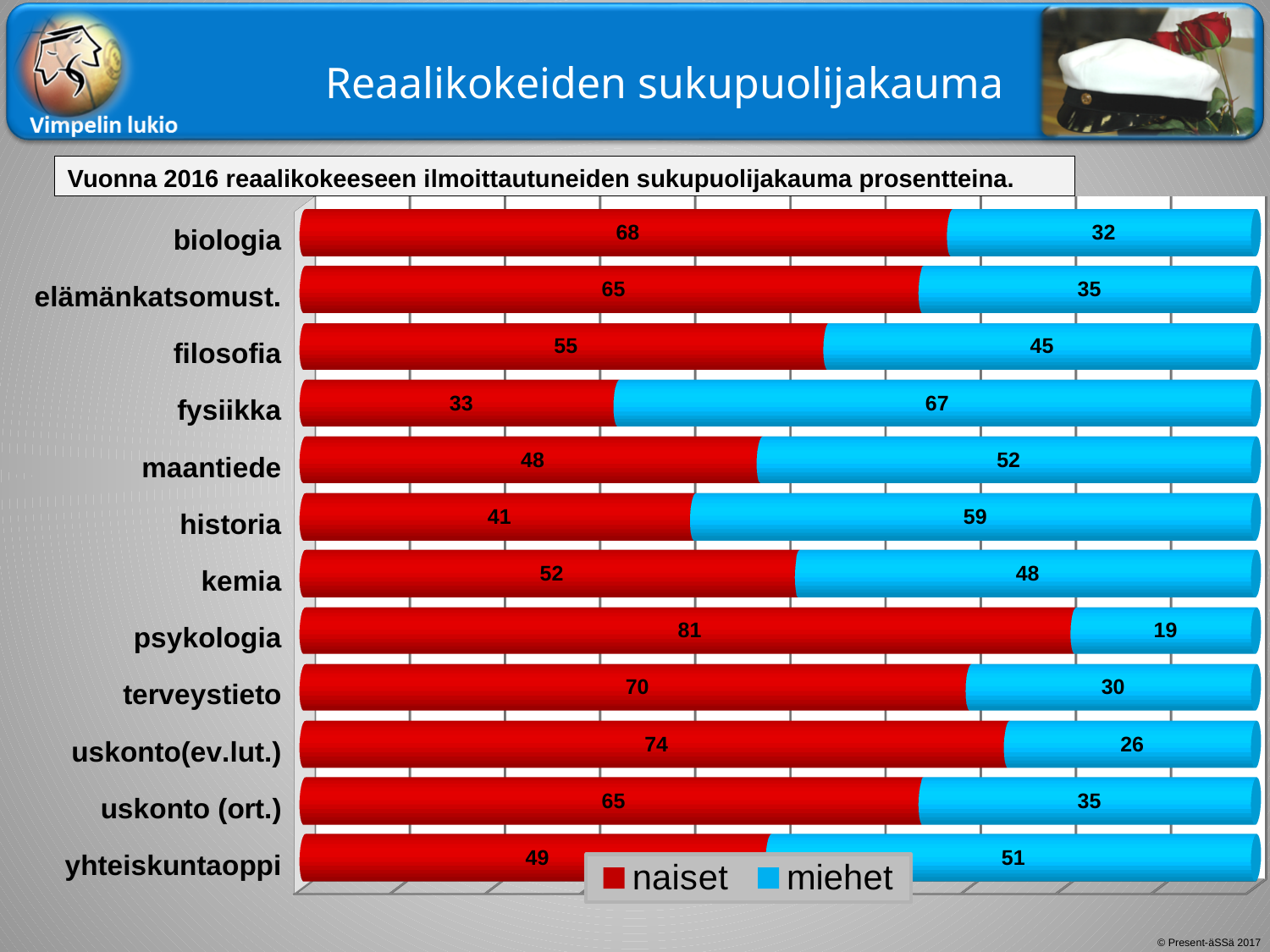
What is the value for naiset in maantiede? 48 What is the value for miehet in fysiikka? 67 What is the difference between the naiset and miehet values for biologia? 36 Which category has the lowest value for naiset? fysiikka What is the total of the stacked bar for kemia? 100 How many series does the legend list? 2 Which category has the highest value for naiset? psykologia What kind of chart is shown on the slide? stacked bar chart How many categories are shown on the chart? 12 Which series is shown in red? naiset What is the value for naiset in psykologia? 81 Which is larger for historia, the naiset value or the miehet value? miehet